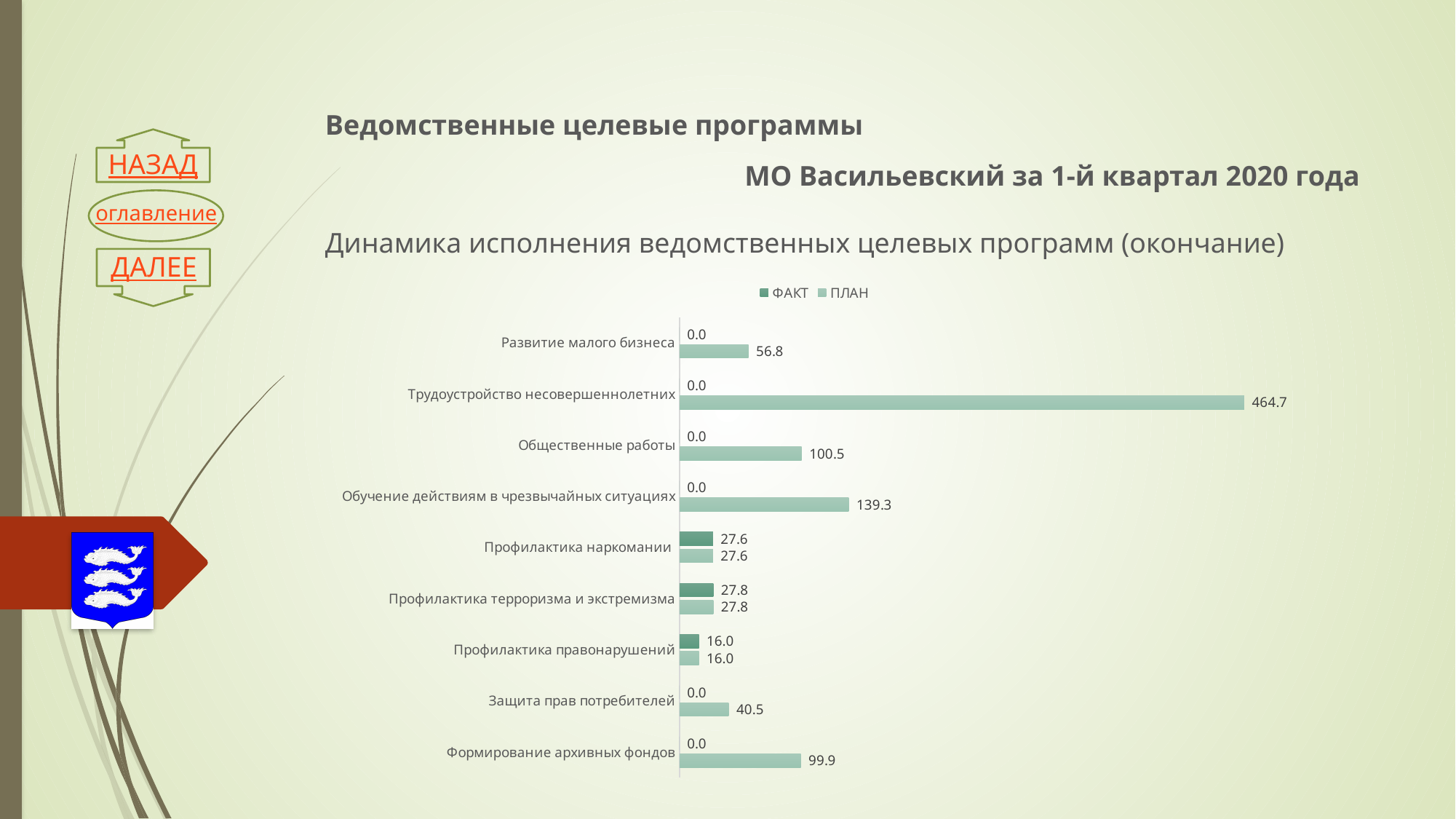
What is the ПЛАН value for Формирование архивных фондов? 99.9 What is the ПЛАН value for Трудоустройство несовершеннолетних? 464.7 What is the ФАКТ value for Развитие малого бизнеса? 0.0 What are the two series named in the legend? ФАКТ and ПЛАН Which category has the lowest ПЛАН value? Профилактика правонарушений Which category has the highest ПЛАН value? Трудоустройство несовершеннолетних How many series does the legend list? 2 What kind of chart is shown on the slide? Bar chart How many categories are shown in the chart? 9 What is the difference between the ПЛАН values for Общественные работы and Защита прав потребителей? 60.0 Which is larger: the ПЛАН value for Обучение действиям в чрезвычайных ситуациях or the ПЛАН value for Развитие малого бизнеса? Обучение действиям в чрезвычайных ситуациях What is the ФАКТ value for Профилактика наркомании? 27.6